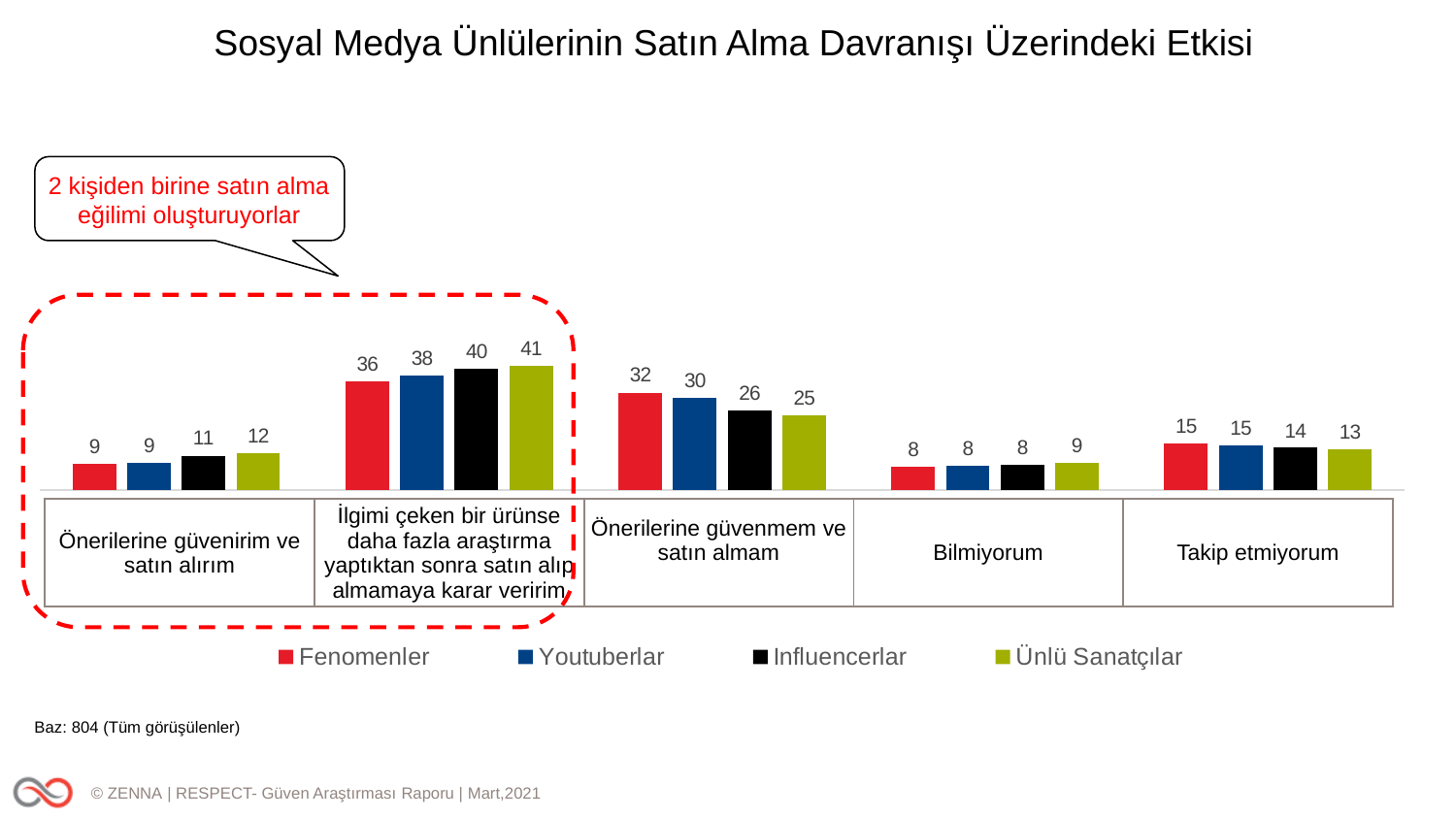
What is the value for Fenomenler in the 'Önerilerine güvenirim ve satın alırım' category? 9 What is the difference between the Fenomenler and Ünlü Sanatçılar values in the 'Önerilerine güvenmem ve satın almam' category? 7 Which category has the lowest value for Ünlü Sanatçılar? Bilmiyorum What is the value for Ünlü Sanatçılar in the 'İlgimi çeken bir ürünse daha fazla araştırma yaptıktan sonra satın alıp almamaya karar veririm' category? 41 Which category has the highest value for Fenomenler? İlgimi çeken bir ürünse daha fazla araştırma yaptıktan sonra satın alıp almamaya karar veririm How many categories are shown on the x axis? 5 What is the value for Influencerlar in the 'Önerilerine güvenmem ve satın almam' category? 26 What is the value for Youtuberlar in the 'Takip etmiyorum' category? 15 What is the base (Baz) stated below the chart? 804 (Tüm görüşülenler) In the 'Önerilerine güvenirim ve satın alırım' category, which is larger: the value for Influencerlar or the value for Ünlü Sanatçılar? Ünlü Sanatçılar What kind of chart is shown on the slide? Bar chart How many series does the legend list? 4